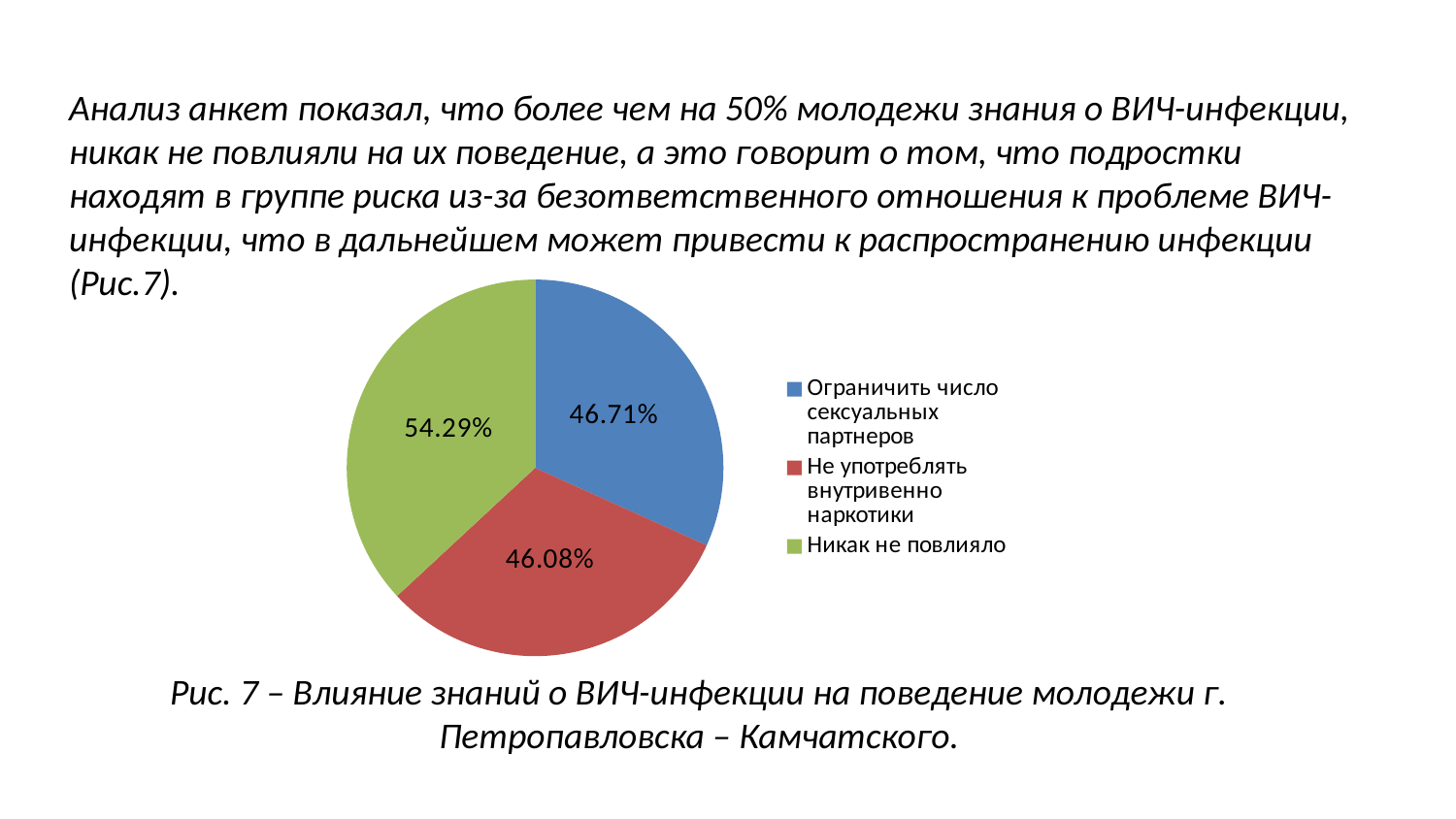
What is the difference between the values for "Никак не повлияло" and "Ограничить число сексуальных партнеров"? 7.58% Which slice of the pie chart has the smallest value? Не употреблять внутривенно наркотики What colour is the slice for "Никак не повлияло"? Green Which slice of the pie chart has the largest value? Никак не повлияло What value is shown for the slice "Ограничить число сексуальных партнеров"? 46.71% Which is larger: the value for "Ограничить число сексуальных партнеров" or for "Не употреблять внутривенно наркотики"? Ограничить число сексуальных партнеров How many entries does the legend of the pie chart list? 3 What kind of chart is shown on the slide? Pie chart What value is shown for the slice "Не употреблять внутривенно наркотики"? 46.08% What value is shown for the slice "Никак не повлияло"? 54.29% What is the figure number given in the caption below the pie chart? Рис. 7 How many slices does the pie chart have? 3